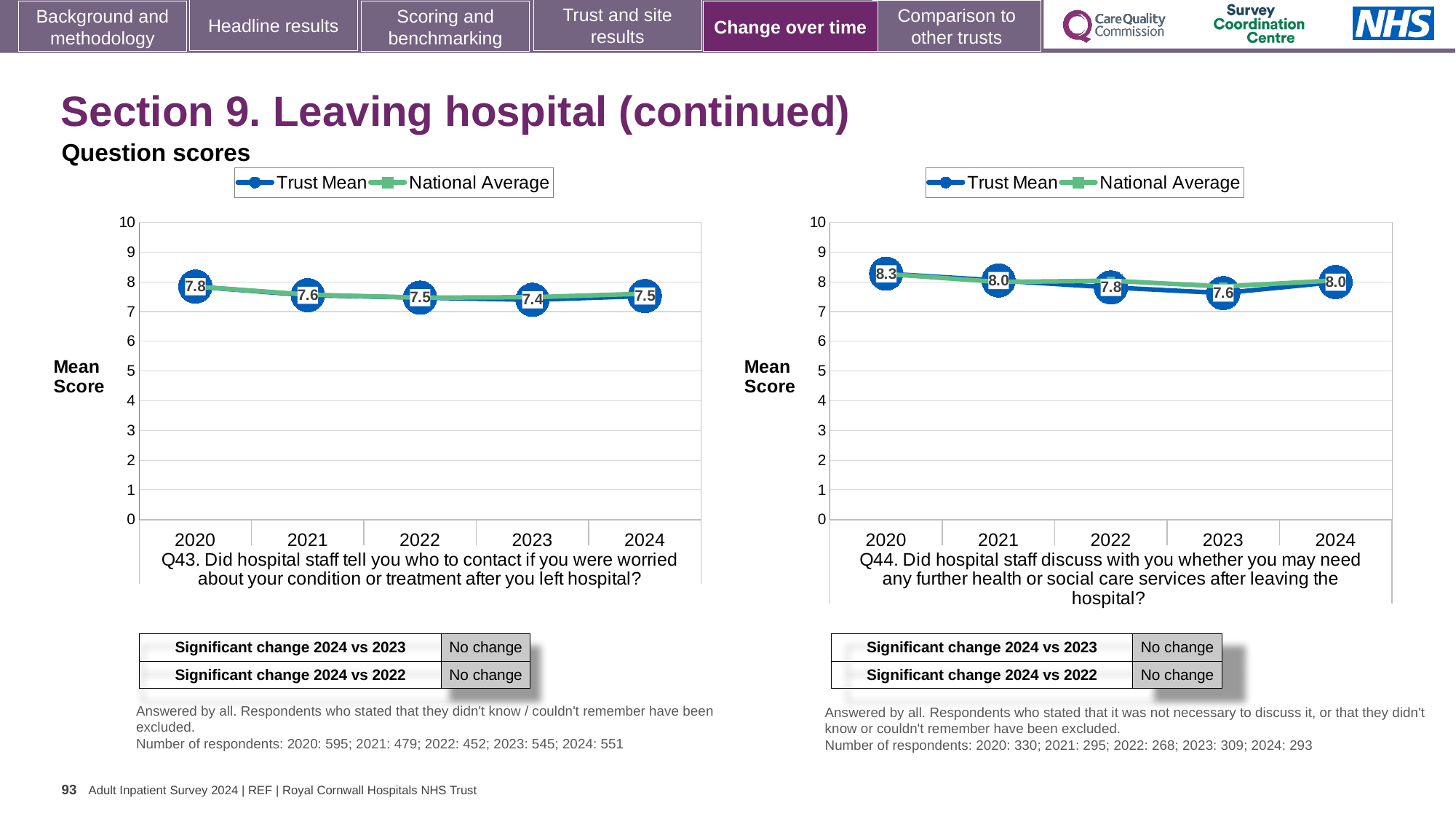
In the Q44 chart (right), which year has the lowest Trust Mean score? 2023 In the Q44 chart (right), what is the difference between the Trust Mean scores for 2020 and 2023? 0.7 In the Q43 chart (left), what is the Trust Mean score for 2023? 7.4 In the Q43 chart (left), what is the difference between the Trust Mean scores for 2020 and 2024? 0.3 In the Q44 chart (right), what is the Trust Mean score for 2020? 8.3 In the Q44 chart (right), what is the Trust Mean score for 2023? 7.6 In the Q43 chart (left), which year has the lowest Trust Mean score? 2023 In the Q43 chart (left), what is the Trust Mean score for 2020? 7.8 In the Q44 chart (right), is the Trust Mean score for 2020 greater or less than the score for 2024? greater How many series does the legend of the Q44 chart (right) list? 2 How many years are plotted on the x axis of the Q43 chart (left)? 5 In the Q43 chart (left), which year has the highest Trust Mean score? 2020